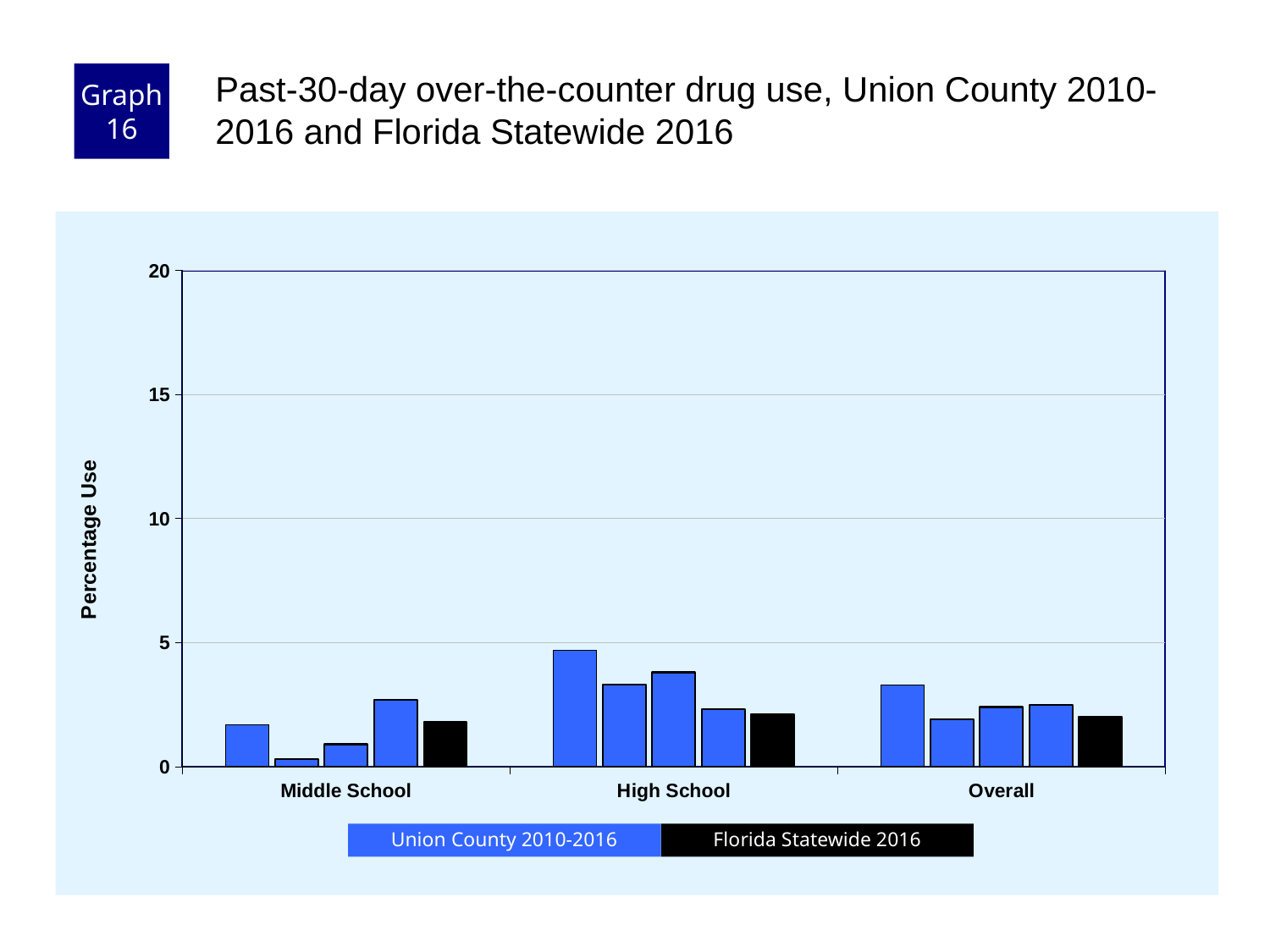
Is the Florida Statewide 2016 value for Overall greater or less than 10? less What is the label of the y axis? Percentage Use Which category contains the tallest bar in the chart? High School Which category contains the shortest bar in the chart? Middle School Which series is shown in black in the chart? Florida Statewide 2016 Are all the bars in the chart below the 5 gridline? yes What kind of chart is shown on the slide? bar chart How many categories are shown on the x axis of the chart? 3 Is the tallest Union County bar larger for High School or for Middle School? High School Is the Florida Statewide 2016 value for High School greater or less than 5? less How many series does the chart legend list? 2